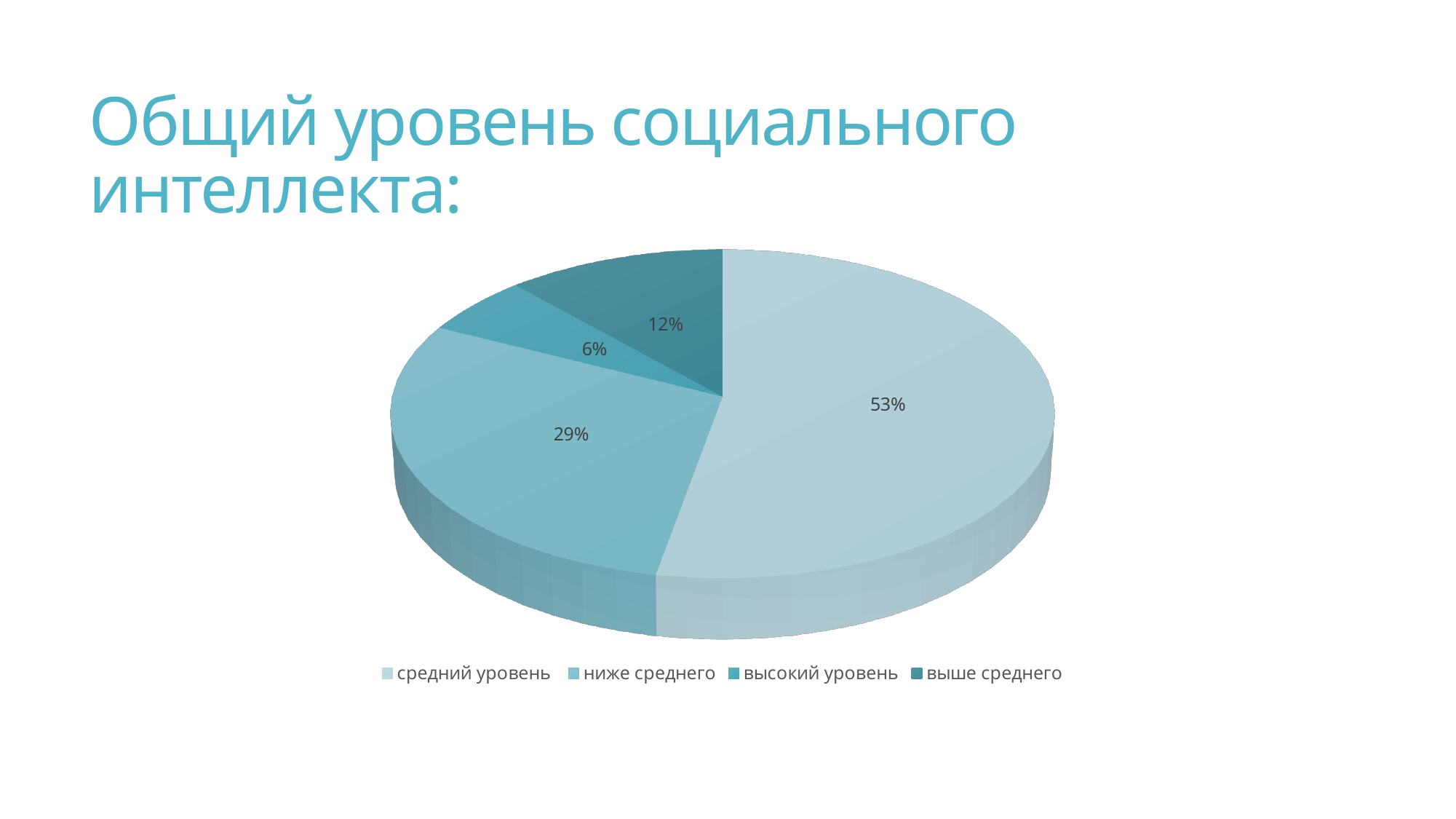
Which is larger, the share of "выше среднего" or the share of "высокий уровень"? выше среднего What share of the pie does "выше среднего" have? 12% What is the difference between the shares of "выше среднего" and "высокий уровень"? 6% What share of the pie does "высокий уровень" have? 6% Which category has the smallest slice of the pie? высокий уровень What share of the pie does "ниже среднего" have? 29% What kind of chart is shown on the slide? pie chart What is the title of the slide containing the chart? Общий уровень социального интеллекта: How many categories does the pie chart have? 4 Which category has the largest slice of the pie? средний уровень What is the difference between the shares of "средний уровень" and "ниже среднего"? 24%